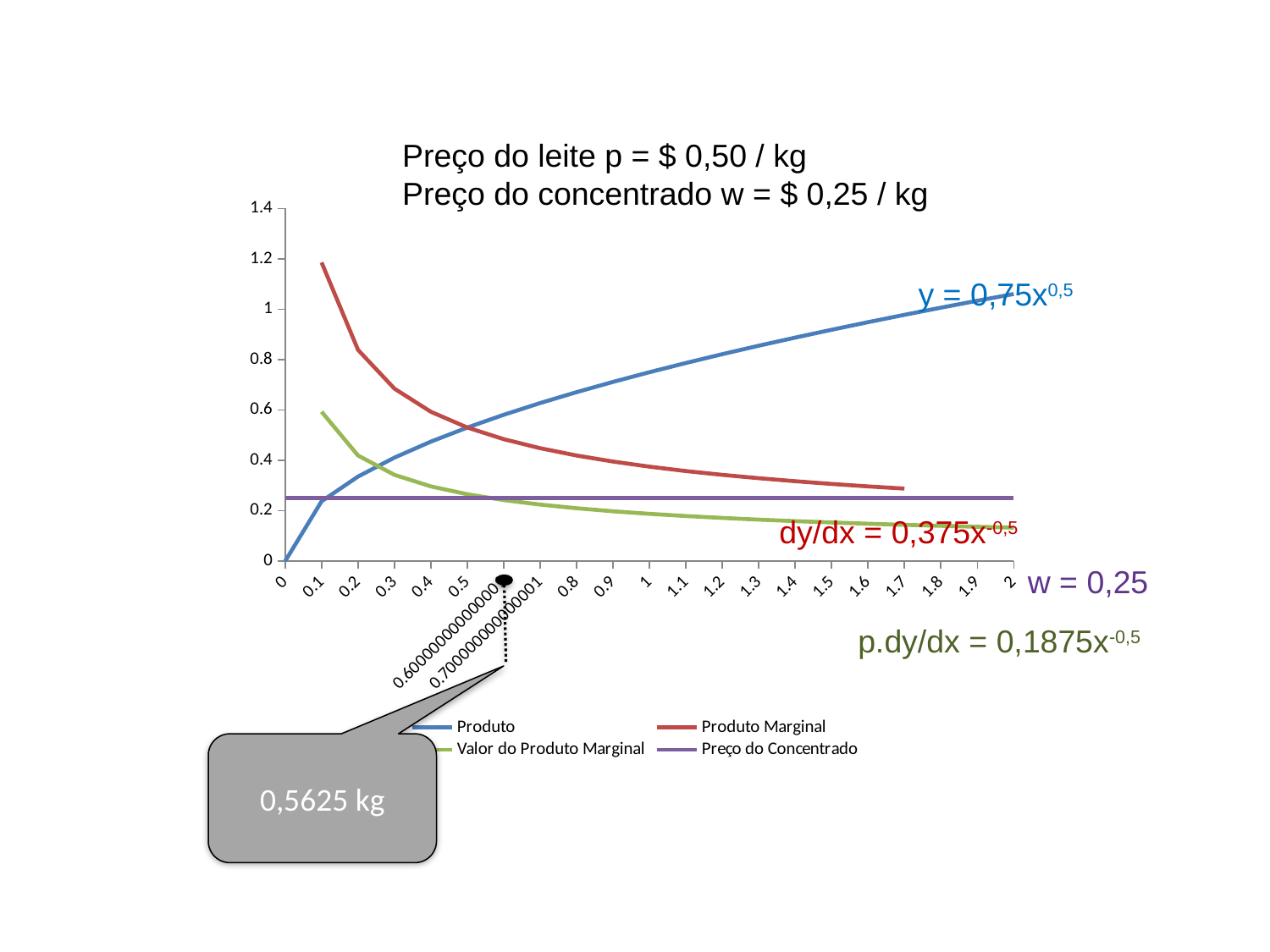
What is the constant value of the Preço do Concentrado line (w)? 0,25 At x = 1.5, which is higher: Produto or Produto Marginal? Produto Which series has the highest value at x = 0.1? Produto Marginal Does the Produto series rise or fall as x increases? rises What kind of chart is shown on the slide? line chart How many series does the legend list? 4 Is the value of Valor do Produto Marginal at x = 2 greater or less than 0.2? less What value is shown in the grey callout box pointing to the x axis? 0,5625 kg Is the value of Produto at x = 1 greater or less than 0.6? greater Which series has the lowest value at x = 2? Valor do Produto Marginal Is the value of Produto Marginal at x = 0.1 greater or less than 1? greater Does the Produto Marginal series rise or fall as x increases? falls